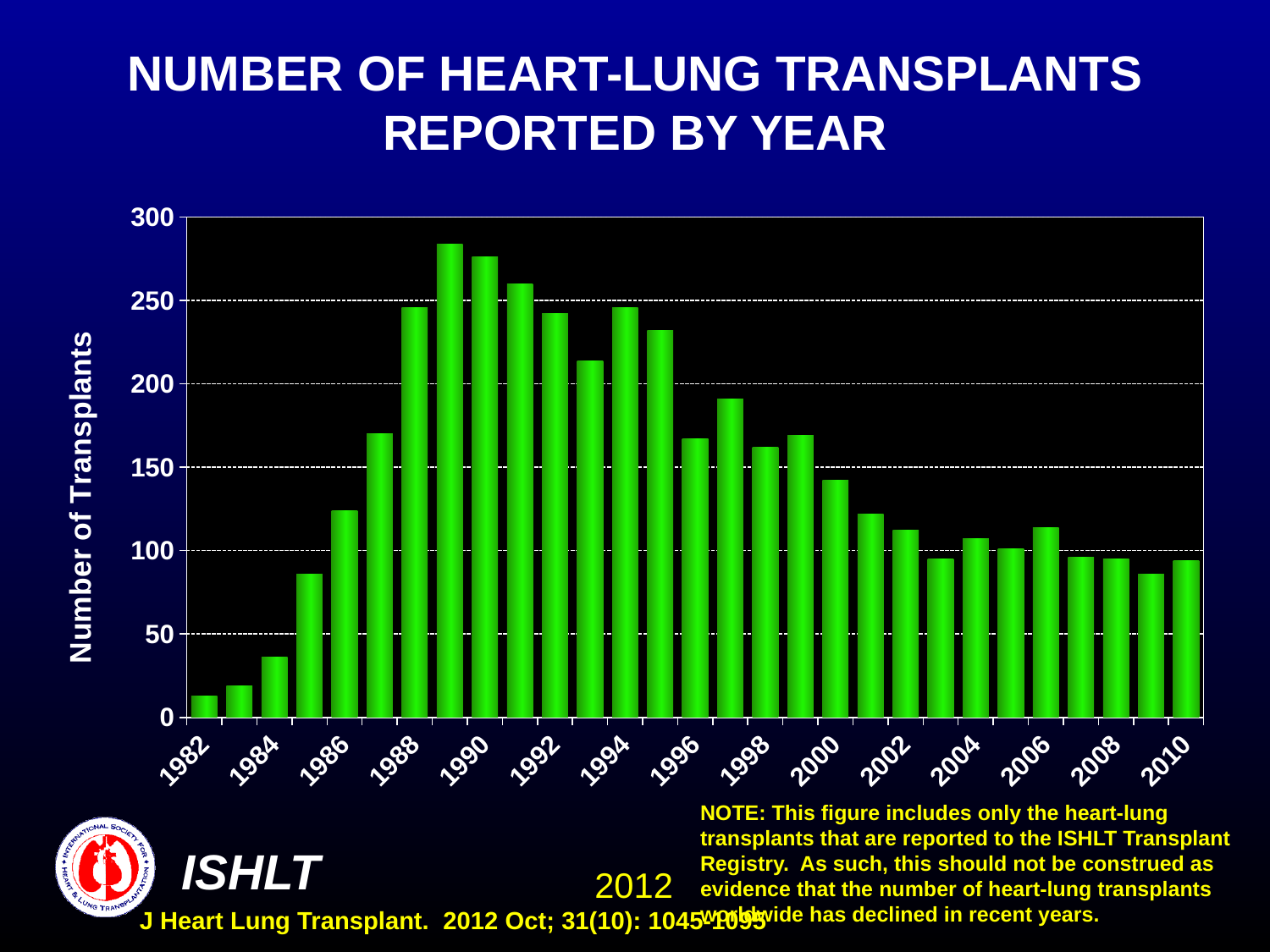
Which year has more heart-lung transplants, 2001 or 2008? 2001 Which year has more heart-lung transplants, 1986 or 1993? 1993 Is the value for 2009 greater or less than 100? less How many years (bars) are plotted on the chart? 29 Which year has the highest number of heart-lung transplants? 1989 What is the label of the vertical axis? Number of Transplants Is the value for 1982 greater or less than 50? less Is the value for 1989 greater or less than 250? greater Which year has the lowest number of heart-lung transplants? 1982 What kind of chart is shown on the slide? bar chart